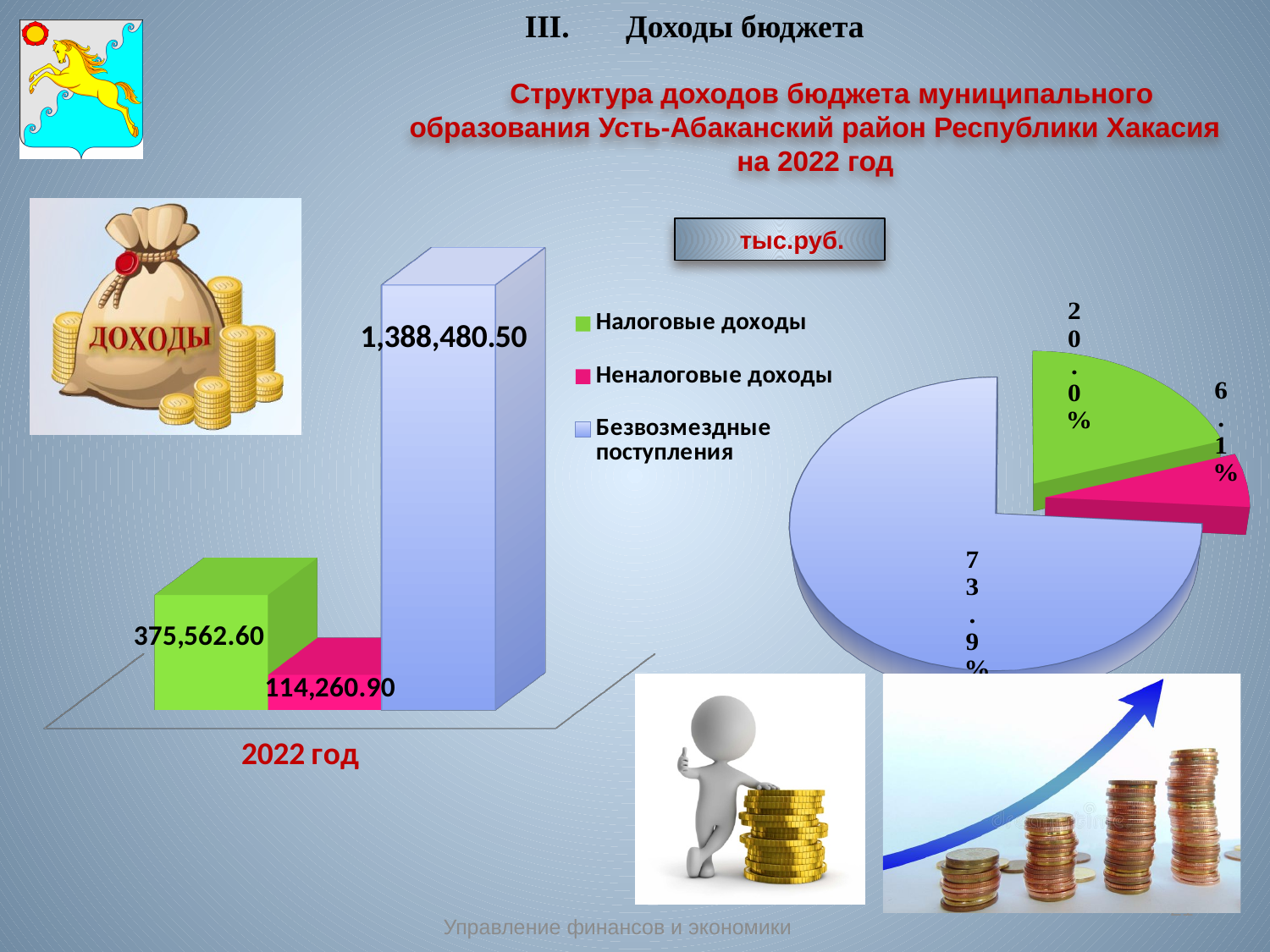
In the bar chart on the left, which category has the highest value? Безвозмездные поступления In the pie chart on the right, what share is shown for the green slice (Налоговые доходы)? 20.0% In the bar chart on the left, what is the value for Неналоговые доходы? 114,260.90 In the pie chart on the right, what share is shown for the pink slice (Неналоговые доходы)? 6.1% In the bar chart on the left, which is larger: Налоговые доходы or Неналоговые доходы? Налоговые доходы How many series does the legend list? 3 In the bar chart on the left, what is the difference between Налоговые доходы and Неналоговые доходы? 261,301.70 What kind of chart is shown on the left of the slide? Bar chart In the bar chart on the left, what is the value for Безвозмездные поступления? 1,388,480.50 In the bar chart on the left, which category has the lowest value? Неналоговые доходы In the bar chart on the left, what is the value for Налоговые доходы? 375,562.60 In the pie chart on the right, what share is shown for the largest slice (Безвозмездные поступления)? 73.9%